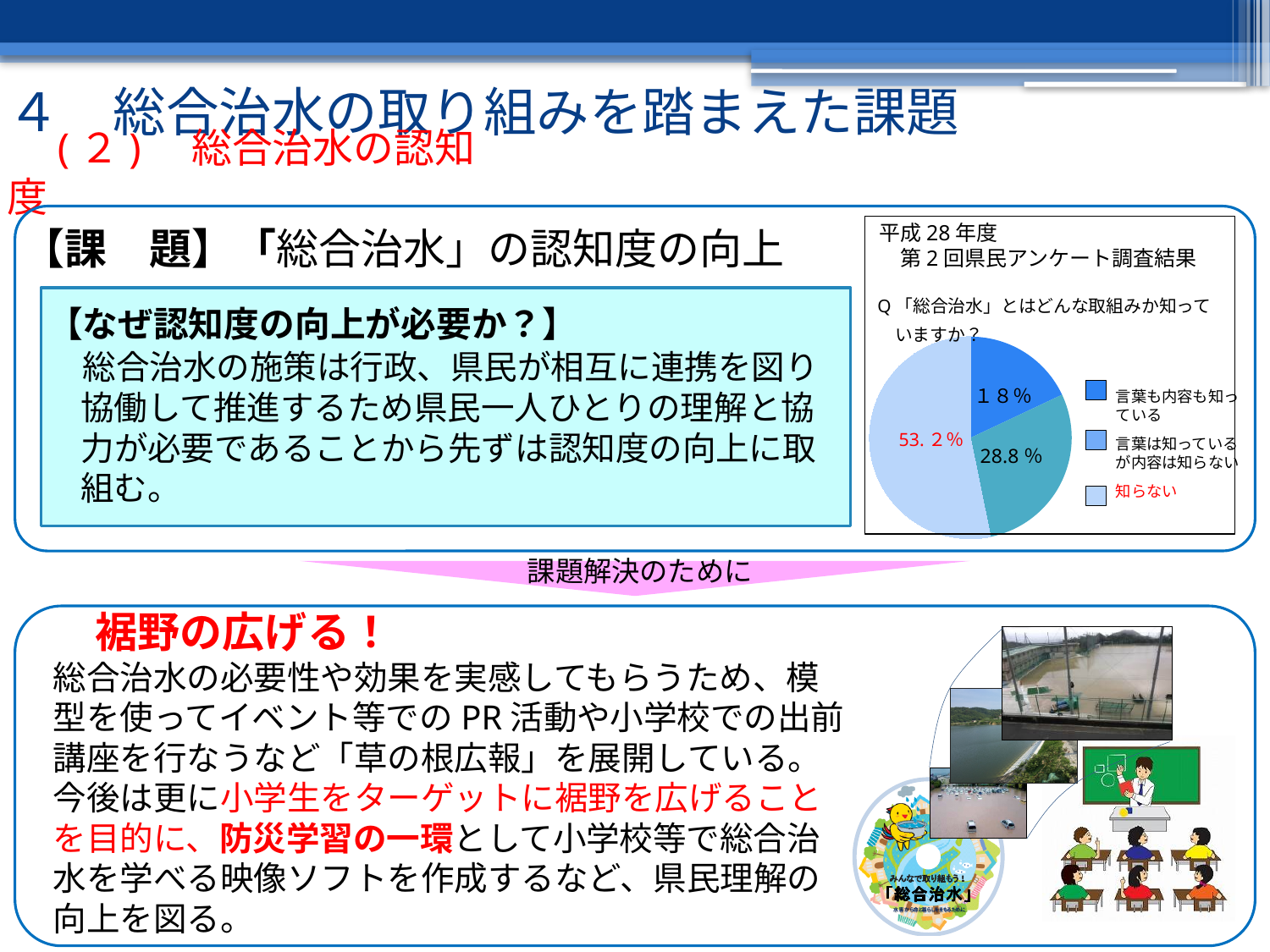
What percentage of respondents answered 「知らない」 in the pie chart? 53.2% Which response has the smallest share in the pie chart? 言葉も内容も知っている How many entries does the pie chart's legend list? 3 What kind of chart is shown on the slide? pie chart What is the difference in percentage points between 「知らない」 and 「言葉は知っているが内容は知らない」? 24.4 What percentage of respondents answered 「言葉は知っているが内容は知らない」 in the pie chart? 28.8% How many slices does the pie chart have? 3 Which is larger in the pie chart: 「言葉は知っているが内容は知らない」 or 「言葉も内容も知っている」? 言葉は知っているが内容は知らない Which response has the largest share in the pie chart? 知らない What percentage of respondents answered 「言葉も内容も知っている」 in the pie chart? 18% What is the difference in percentage points between 「言葉は知っているが内容は知らない」 and 「言葉も内容も知っている」? 10.8 What survey is the pie chart based on, according to the text above it? 平成28年度 第2回県民アンケート調査結果